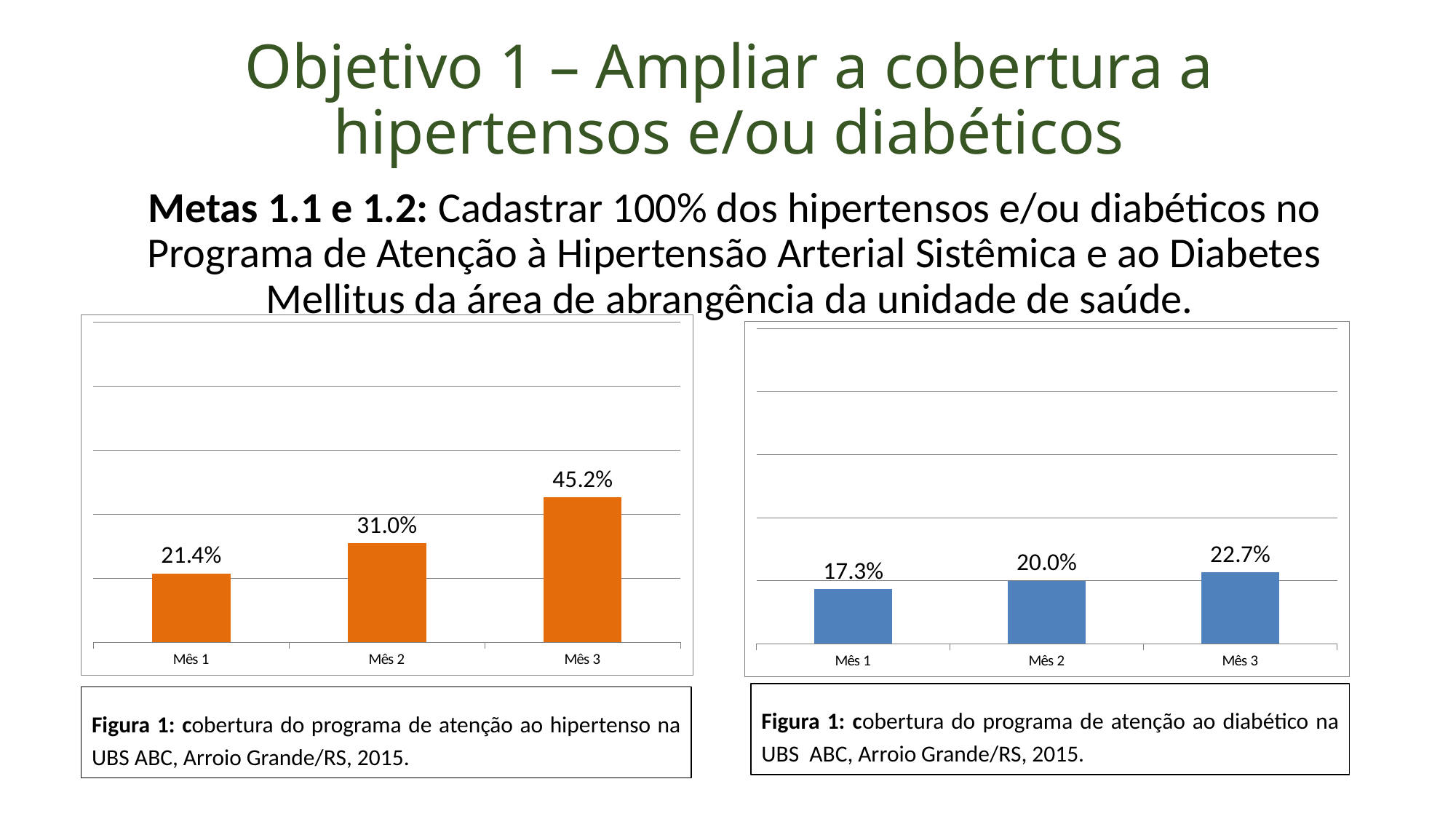
In the right chart, what is the difference between the values for Mês 3 and Mês 2? 2.7% What colour are the bars in the right chart? blue In the right chart, which month has the lowest value? Mês 1 In the left chart, what is the difference between the values for Mês 3 and Mês 1? 23.8% In the right chart, is the value for Mês 2 larger or smaller than the value for Mês 3? smaller In the left chart, do the values rise or fall from Mês 1 to Mês 3? rise In the right chart (cobertura do programa de atenção ao diabético), what is the value for Mês 1? 17.3% In the left chart (cobertura do programa de atenção ao hipertenso), what is the value for Mês 2? 31.0% In the left chart, which month has the highest value? Mês 3 Which is larger: the value for Mês 3 in the left chart or the value for Mês 3 in the right chart? Mês 3 in the left chart What kind of chart is the right chart? bar chart How many bars are plotted in the left chart? 3